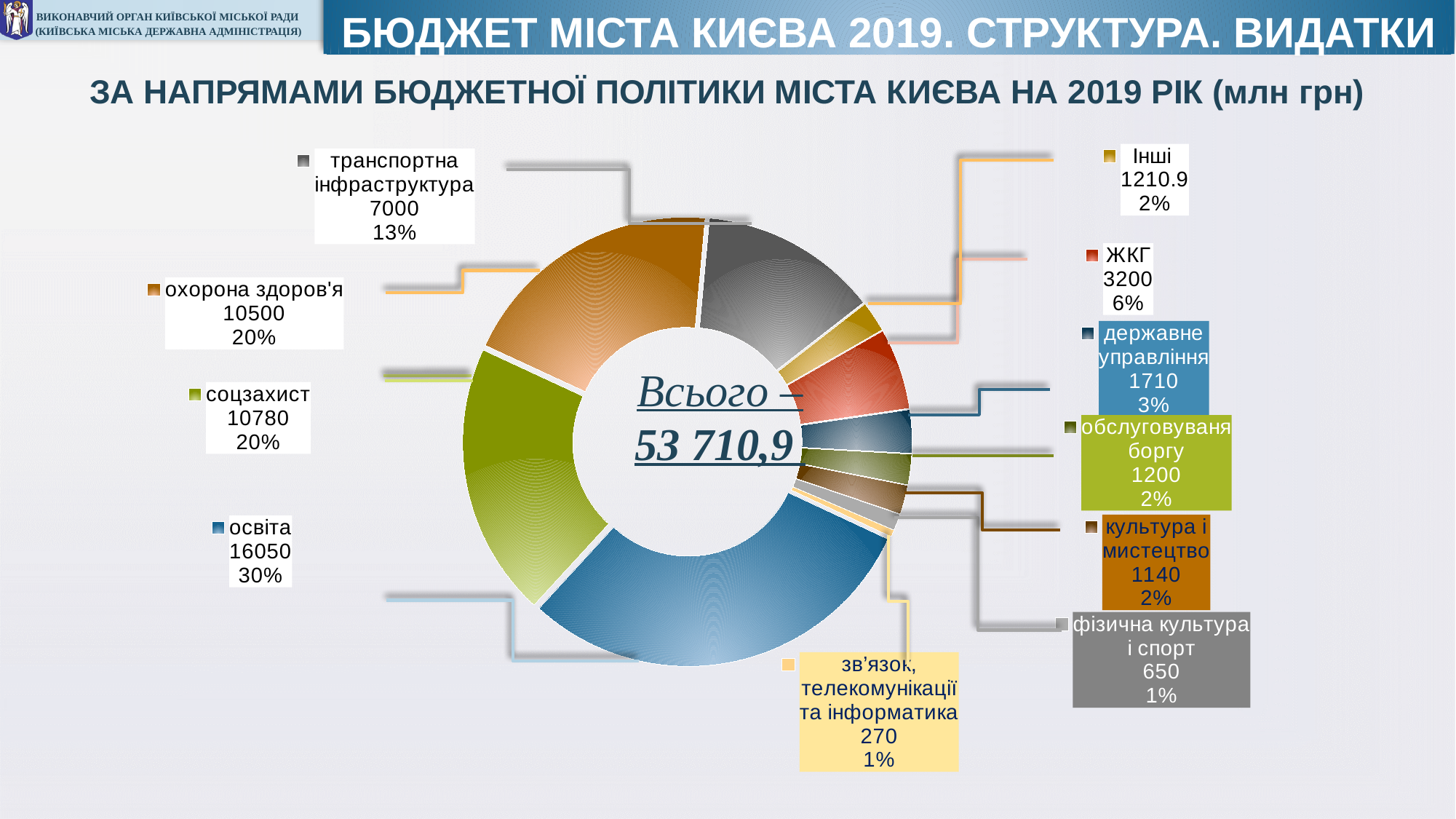
What is the difference between the values for соцзахист and охорона здоров'я? 280 Which category has the smallest value? зв'язок, телекомунікації та інформатика Which is larger, the value for транспортна інфраструктура or the value for ЖКГ? транспортна інфраструктура What kind of chart is shown on the slide? Doughnut (pie) chart What is the value for освіта? 16050 What total is printed in the centre of the chart? 53 710,9 What is the value for державне управління? 1710 What share of the total does охорона здоров'я represent? 20% How many categories are shown in the chart? 11 What is the value for ЖКГ? 3200 Which category has the largest value? освіта What share of the total does фізична культура і спорт represent? 1%